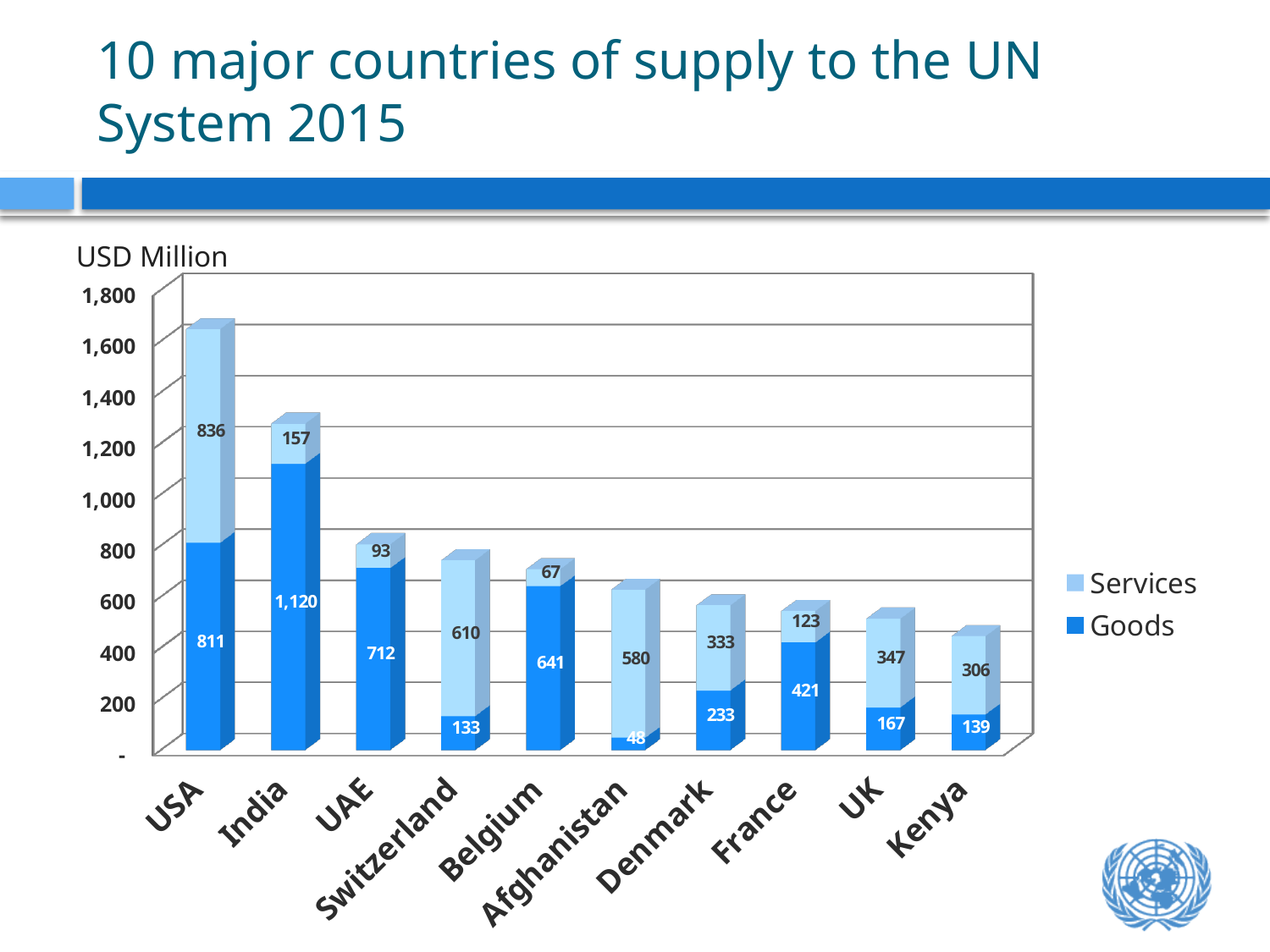
Which country has the lowest Goods value? Afghanistan What is the total of the stacked bar for Kenya? 445 What is the total of the stacked bar for UAE? 805 How many countries are shown on the x axis? 10 How many series does the legend list? 2 What kind of chart is shown on the slide? Stacked bar chart What is the Services value for Switzerland? 610 Which country has the highest Goods value? India What is the Goods value for India? 1,120 What is the difference between the Services value for USA and the Services value for India? 679 Which is larger, the Goods value for Denmark or the Goods value for France? France What is the Goods value for Afghanistan? 48